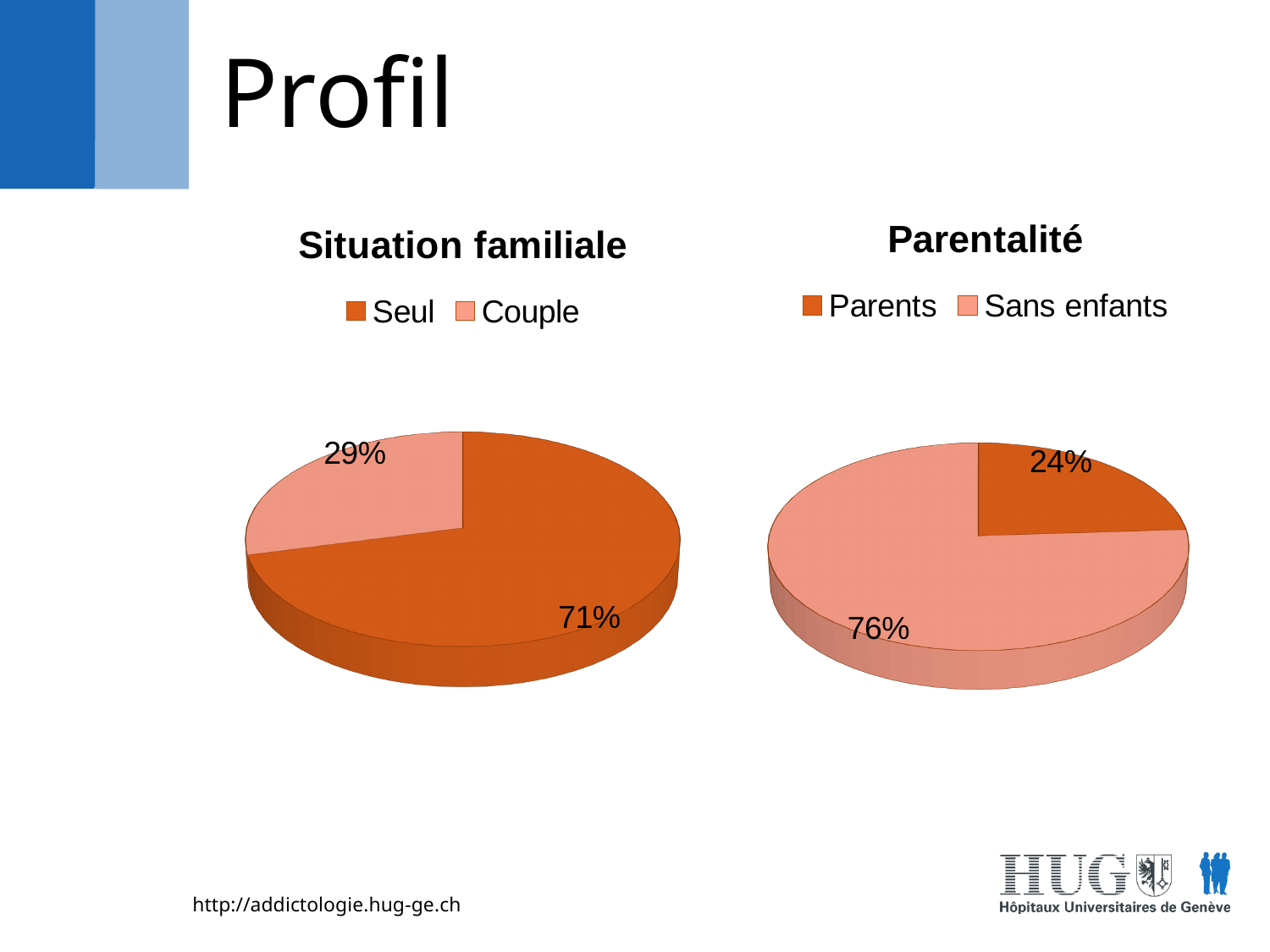
In the 'Situation familiale' chart, what is the difference in percentage points between Seul and Couple? 42 In the 'Parentalité' chart, which is larger, Parents or Sans enfants? Sans enfants In the 'Situation familiale' chart, what share is labelled for Couple? 29% How many categories does the 'Parentalité' chart show? 2 In the 'Situation familiale' chart, which category has the largest slice? Seul In the 'Parentalité' chart, which category has the smallest slice? Parents In the 'Parentalité' chart, what is the difference in percentage points between Sans enfants and Parents? 52 What kind of chart is the 'Situation familiale' chart? Pie chart In the 'Situation familiale' chart, what share is labelled for Seul? 71% In the 'Parentalité' chart, what share is labelled for Parents? 24% What are the legend entries of the 'Situation familiale' chart? Seul, Couple In the 'Parentalité' chart, what share is labelled for Sans enfants? 76%